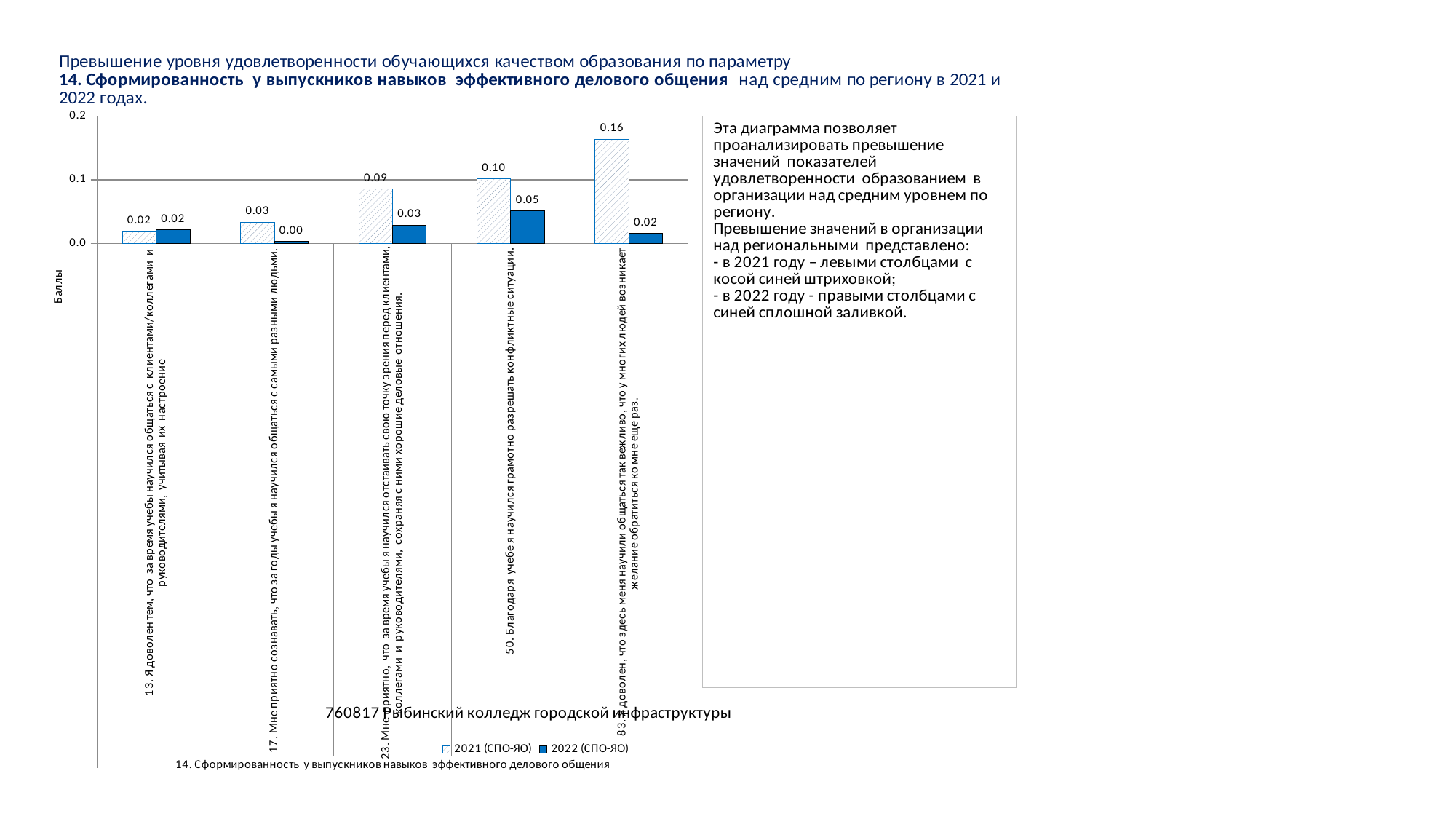
What is the 2021 (СПО-ЯО) value for statement 83 ("Я доволен, что здесь меня научили общаться так вежливо...")? 0.16 How many statements (categories) are shown on the x axis of the chart? 5 What is the difference between the 2021 and 2022 values for statement 83? 0.14 What type of chart is shown on the slide? bar chart What is the difference between the 2021 and 2022 values for statement 23? 0.06 Is the 2021 (СПО-ЯО) value for statement 83 greater or less than 0.1? greater How many series does the chart legend list? 2 What is the 2022 (СПО-ЯО) value for statement 17 ("Мне приятно сознавать, что за годы учебы я научился общаться с самыми разными людьми")? 0.00 Which statement has the lowest 2022 (СПО-ЯО) value? 17. Мне приятно сознавать, что за годы учебы я научился общаться с самыми разными людьми. For statement 50, which is larger: the 2021 (СПО-ЯО) value or the 2022 (СПО-ЯО) value? 2021 (СПО-ЯО) What is the 2022 (СПО-ЯО) value for statement 50 ("Благодаря учебе я научился грамотно разрешать конфликтные ситуации")? 0.05 Which statement has the highest 2021 (СПО-ЯО) value? 83. Я доволен, что здесь меня научили общаться так вежливо, что у многих людей возникает желание обратиться ко мне еще раз.